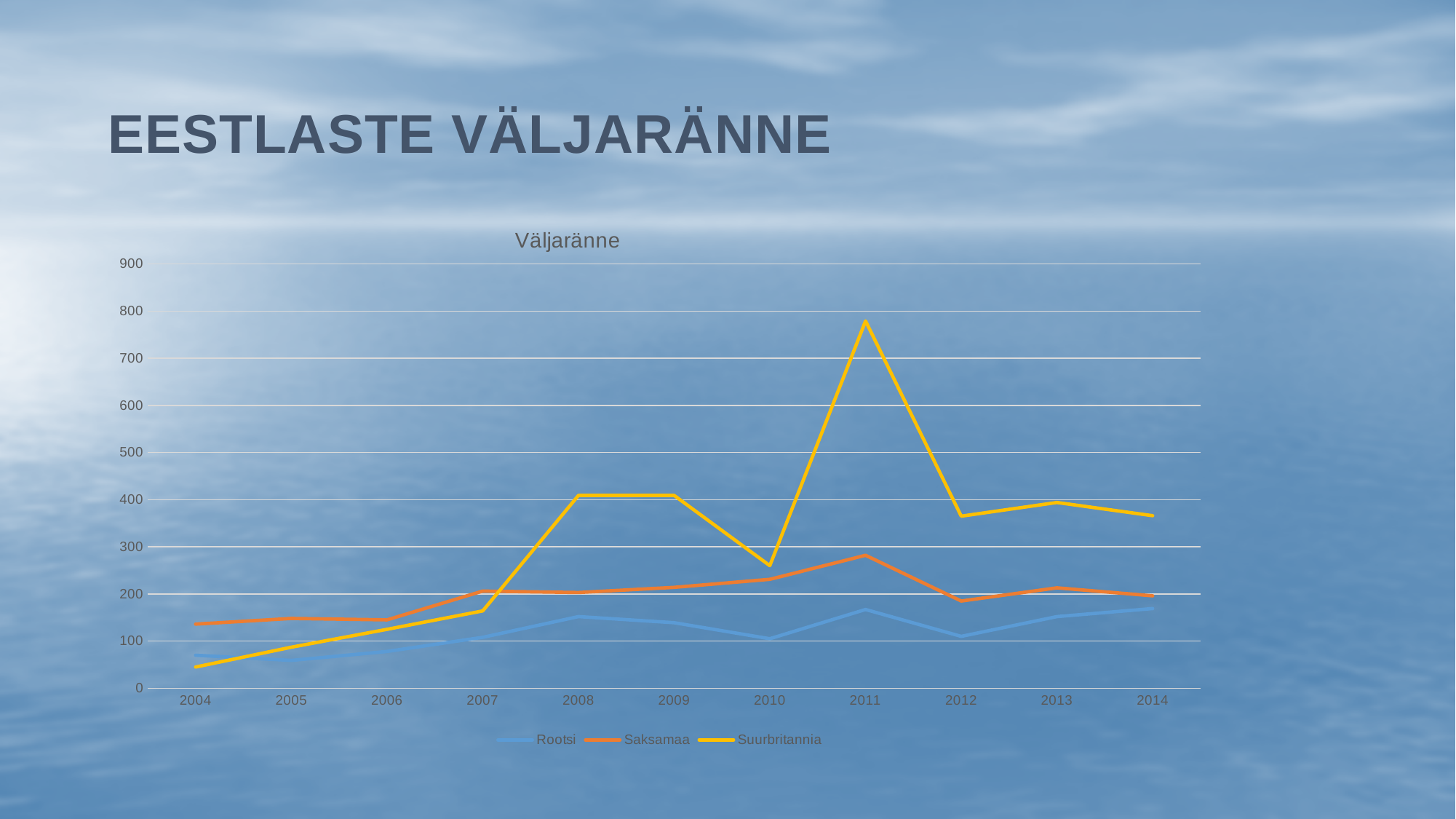
Does the Suurbritannia line rise or fall from 2011 to 2012? fall Is the value for Saksamaa in 2011 greater or less than 200? greater What kind of chart is shown on the slide? line chart What is the title of the chart? Väljaränne Which series has the lowest value in 2014? Rootsi How many series does the legend list? 3 In which year does the Suurbritannia line reach its highest value? 2011 Which series reaches the highest value anywhere on the chart? Suurbritannia Which series has the higher value in 2006, Saksamaa or Suurbritannia? Saksamaa Is the value for Suurbritannia in 2004 greater or less than 100? less Is the value for Suurbritannia in 2011 greater or less than 700? greater How many years are shown on the x axis? 11